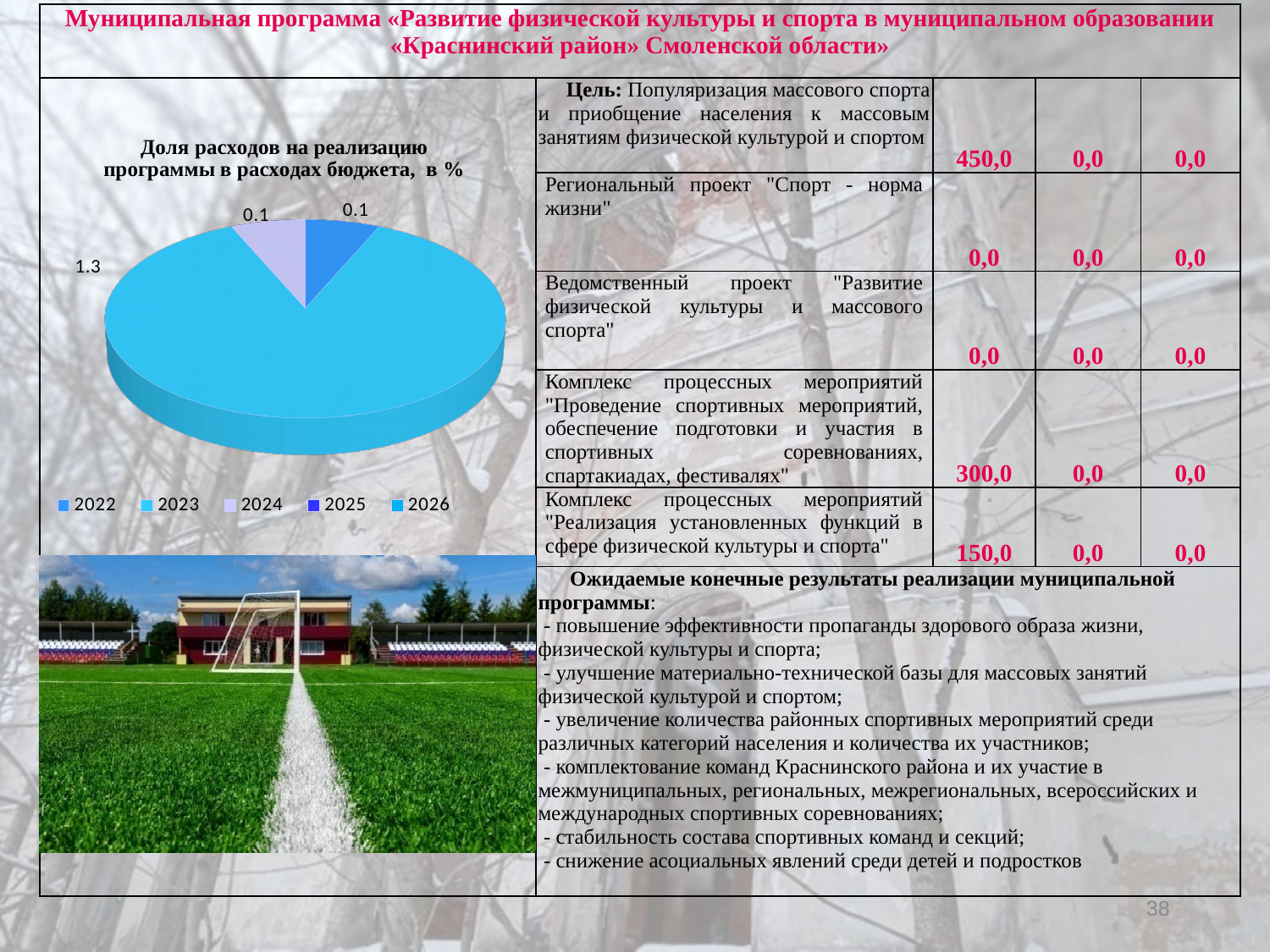
What value is shown for 2022 in the pie chart? 0.1 Which years are listed in the legend of the pie chart? 2022, 2023, 2024, 2025, 2026 What is the title of the pie chart? Доля расходов на реализацию программы в расходах бюджета, в % How many slices with data labels are visible in the pie chart? 3 Which is larger in the pie chart, the value for 2023 or the value for 2024? 2023 What type of chart is shown on the slide? Pie chart How many entries does the legend of the pie chart list? 5 What value is shown for 2023 in the pie chart? 1.3 Which year has the largest slice in the pie chart? 2023 What value is shown for 2024 in the pie chart? 0.1 What is the difference between the values for 2023 and 2022 in the pie chart? 1.2